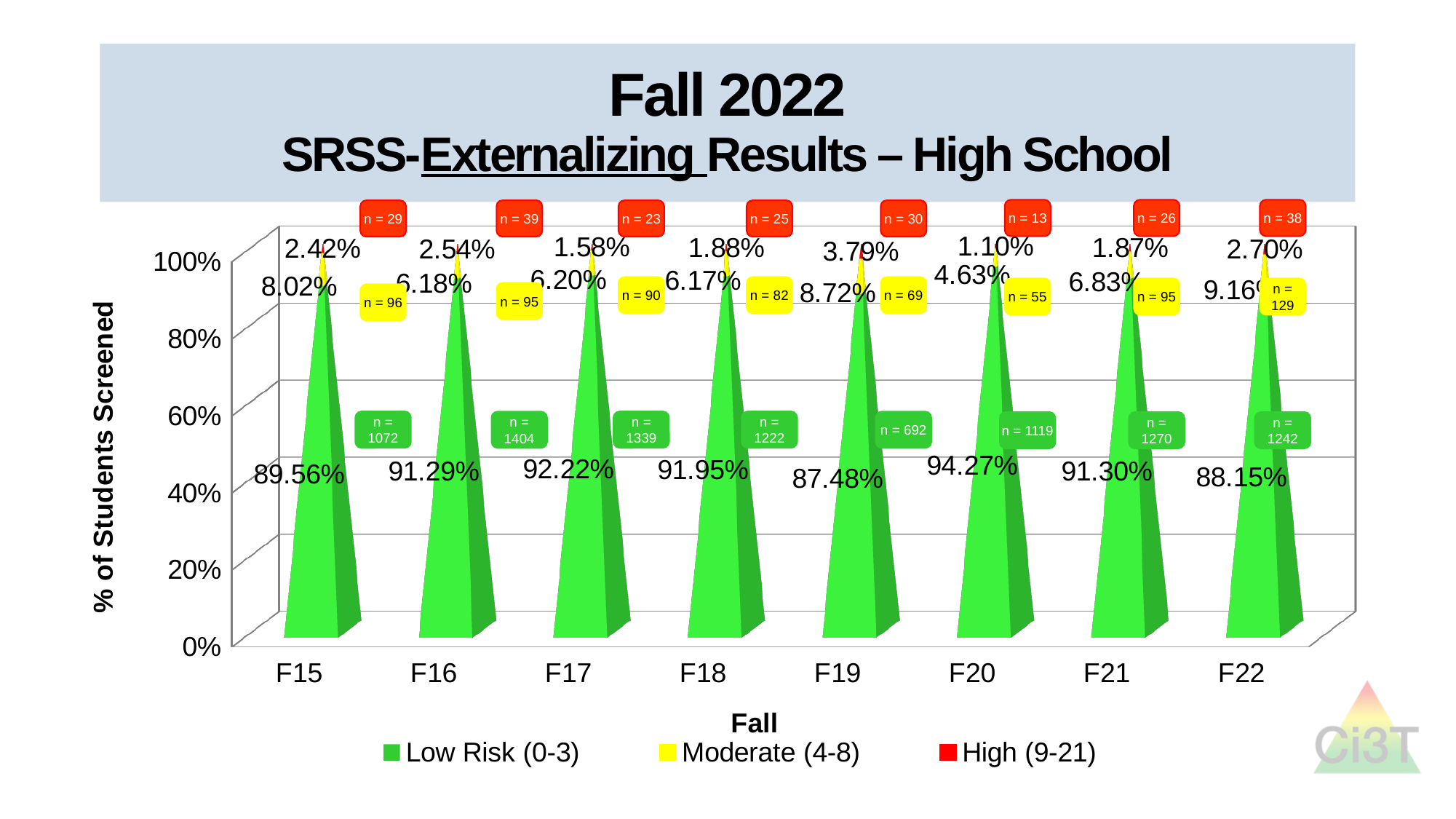
What is the High (9-21) percentage for F19? 3.79% Which has a larger Moderate (4-8) percentage, F19 or F16? F19 What is the Low Risk (0-3) percentage for F20? 94.27% What is the difference between the Low Risk (0-3) percentages for F20 and F19? 6.79 percentage points How many series does the legend list? 3 Which fall has the lowest Low Risk (0-3) percentage? F19 Which fall has the lowest High (9-21) percentage? F20 Which fall has the highest Low Risk (0-3) percentage? F20 Which fall has the highest High (9-21) percentage? F19 How many fall screening periods are shown on the x axis? 8 What is the Moderate (4-8) percentage for F15? 8.02% What is the n value shown for the Low Risk group in F16? n = 1404